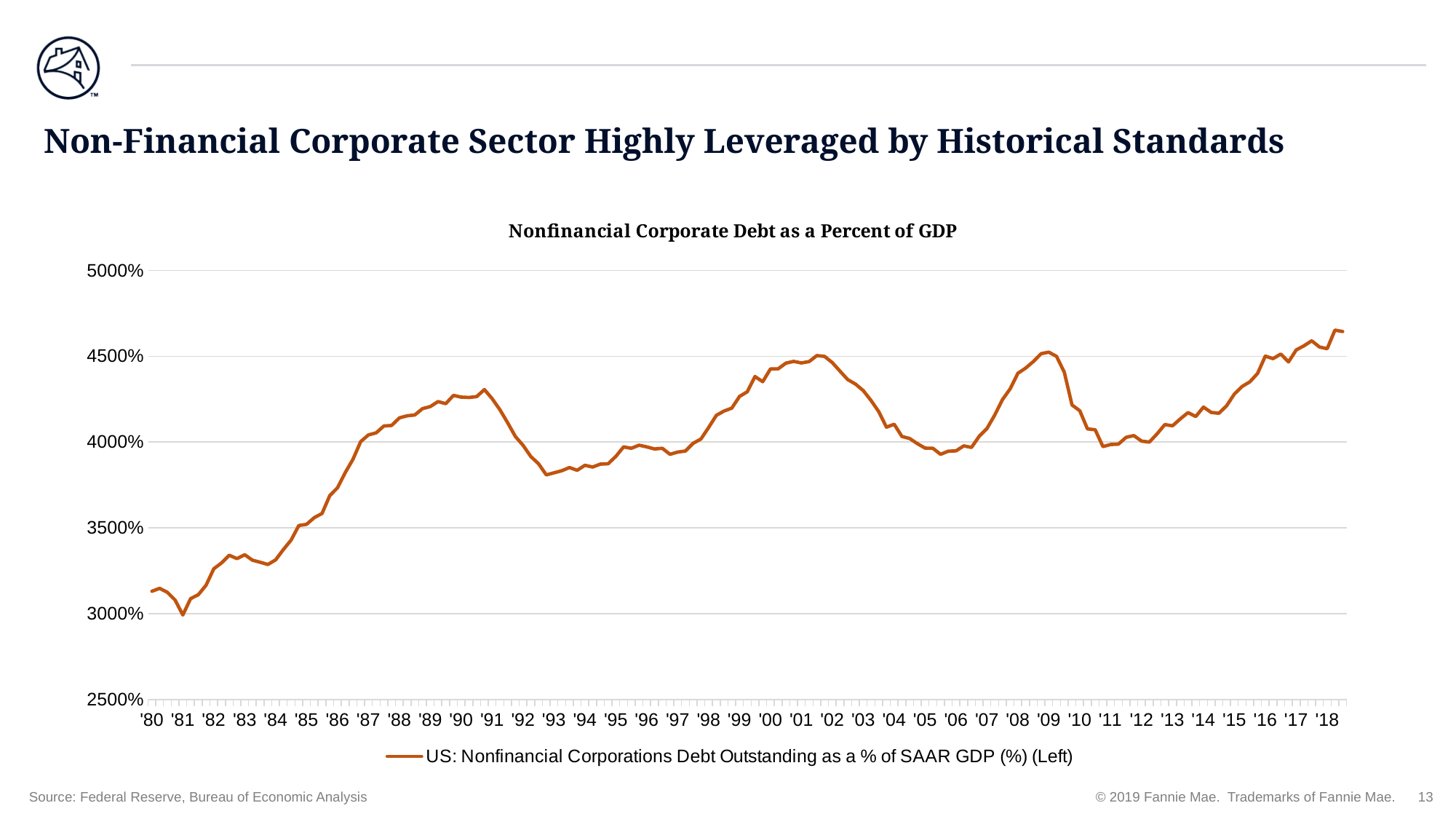
Does the line generally rise or fall between '80 and '91? rise In which year labelled on the x axis does the line reach its highest point? '18 Is the value for '02 greater or less than 4000%? greater Does the line rise or fall between '02 and '06? fall What is the legend entry for the plotted line? US: Nonfinancial Corporations Debt Outstanding as a % of SAAR GDP (%) (Left) Is the value for '93 greater or less than 4000%? less Is the value for '18 greater or less than 4500%? greater What is the title of the chart? Nonfinancial Corporate Debt as a Percent of GDP What kind of chart is shown on the slide? line chart How many series does the legend list? 1 In which year labelled on the x axis does the line reach its lowest point? '81